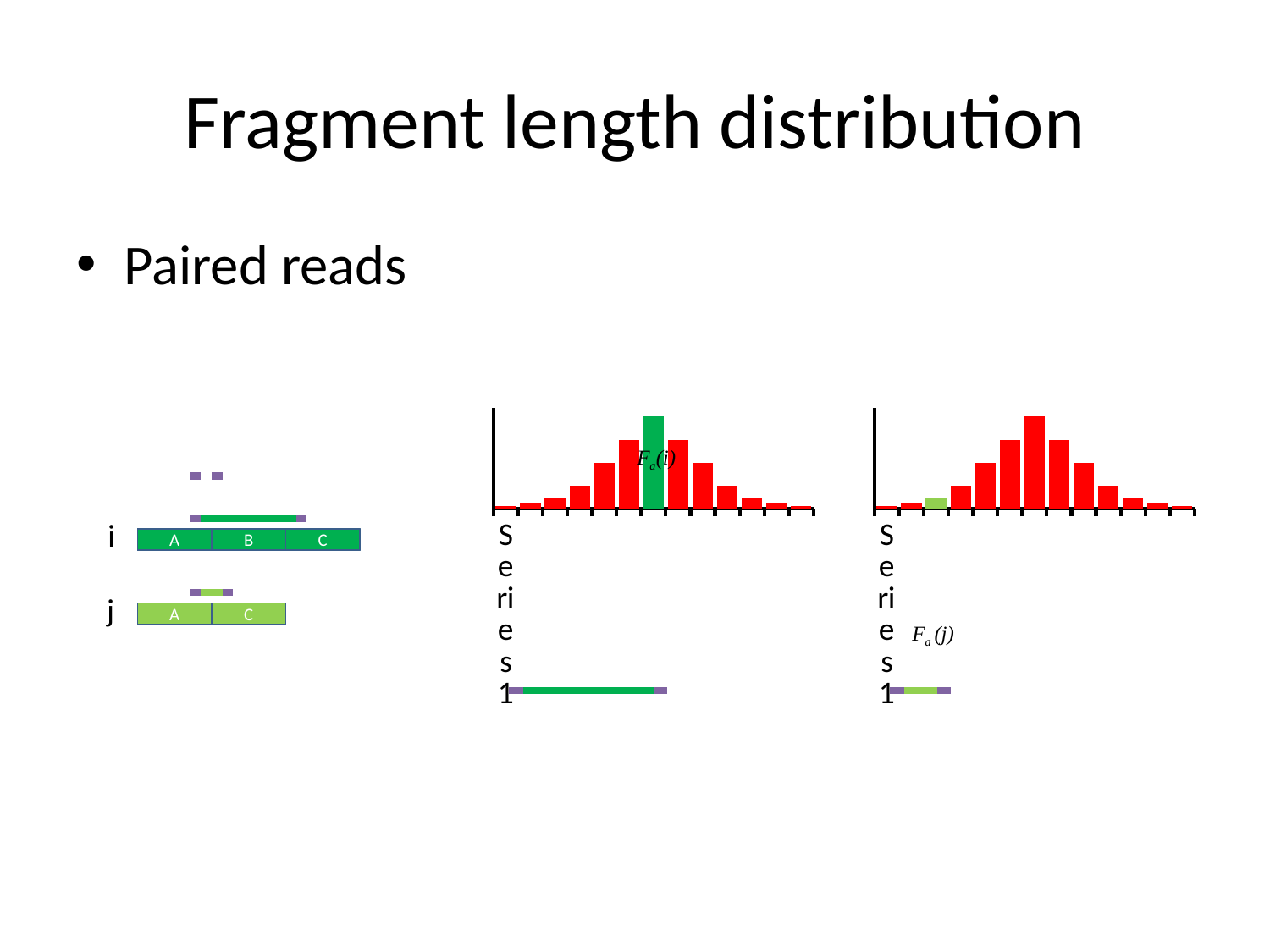
In the right chart, do the bar heights rise or fall moving from the tallest bar toward the right end of the x axis? fall In the right chart, is the highlighted light-green bar taller or shorter than the tallest red bar? shorter What kind of chart is the left chart on the slide? bar chart In the left chart, what colour is the single highlighted bar that differs from the red bars? green In the left chart, do the bar heights rise or fall moving from the leftmost bar toward the middle of the x axis? rise What kind of chart is the right chart on the slide? bar chart In the left chart, is the highlighted green bar taller or shorter than the red bar immediately to its left? taller